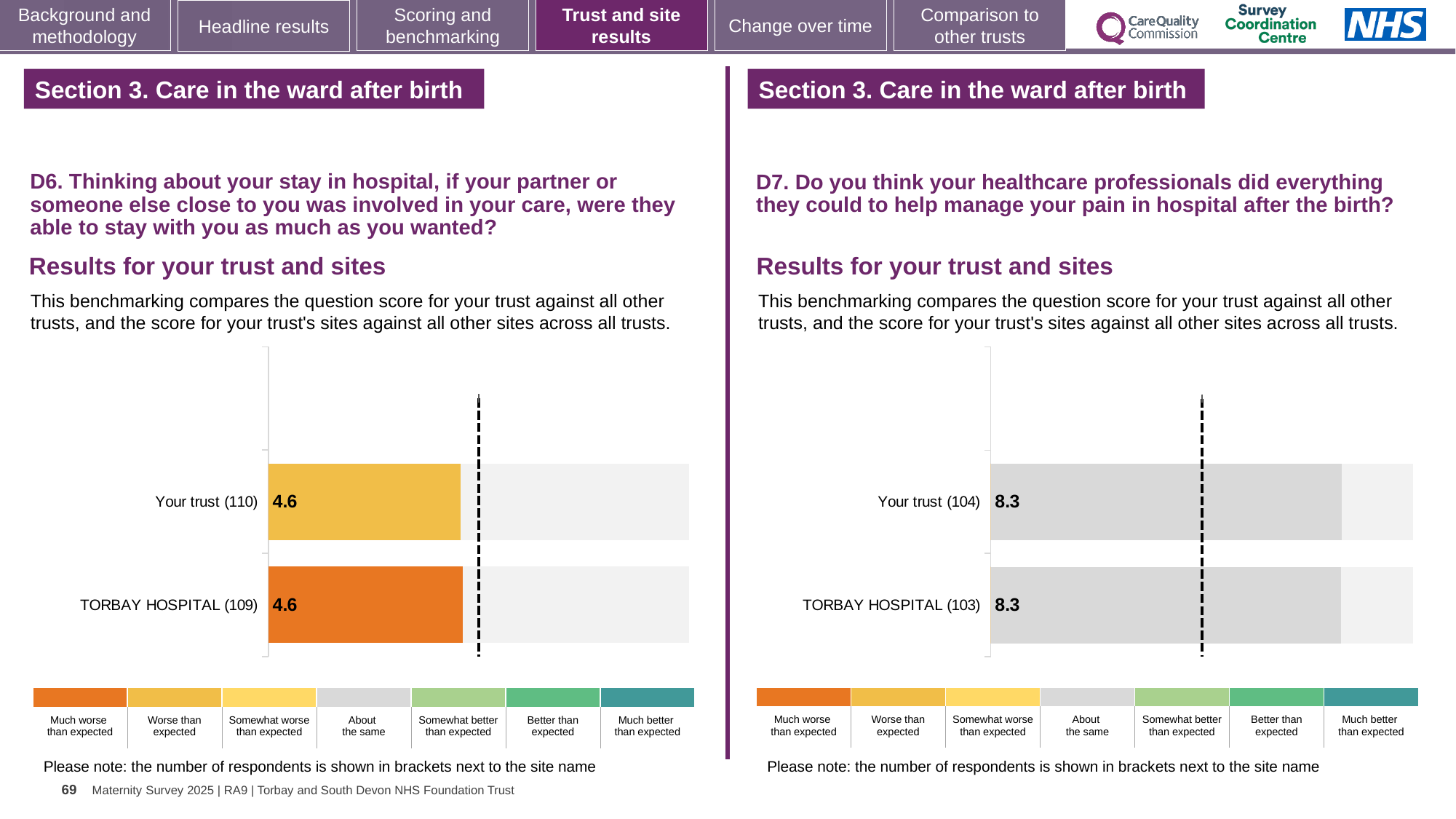
In the D7 chart on the right, what is the difference between the score for Your trust and the score for TORBAY HOSPITAL? 0.0 In the D6 chart on the left, what is the difference between the score for Your trust and the score for TORBAY HOSPITAL? 0.0 In the D7 chart on the right, what is the score for Your trust? 8.3 What kind of chart is used in the D6 chart on the left? Bar chart In the D6 chart on the left, what is the score for Your trust? 4.6 In the D7 chart on the right, how many respondents are shown in brackets for Your trust? 104 How many bars are plotted in the D7 chart on the right? 2 In the D6 chart on the left, how many respondents are shown in brackets for TORBAY HOSPITAL? 109 How many bars are plotted in the D6 chart on the left? 2 In the D7 chart on the right, what is the score for TORBAY HOSPITAL? 8.3 In the D6 chart on the left, what is the score for TORBAY HOSPITAL? 4.6 In the D7 chart on the right, which benchmark category does the grey colour of the bars correspond to according to the legend? About the same